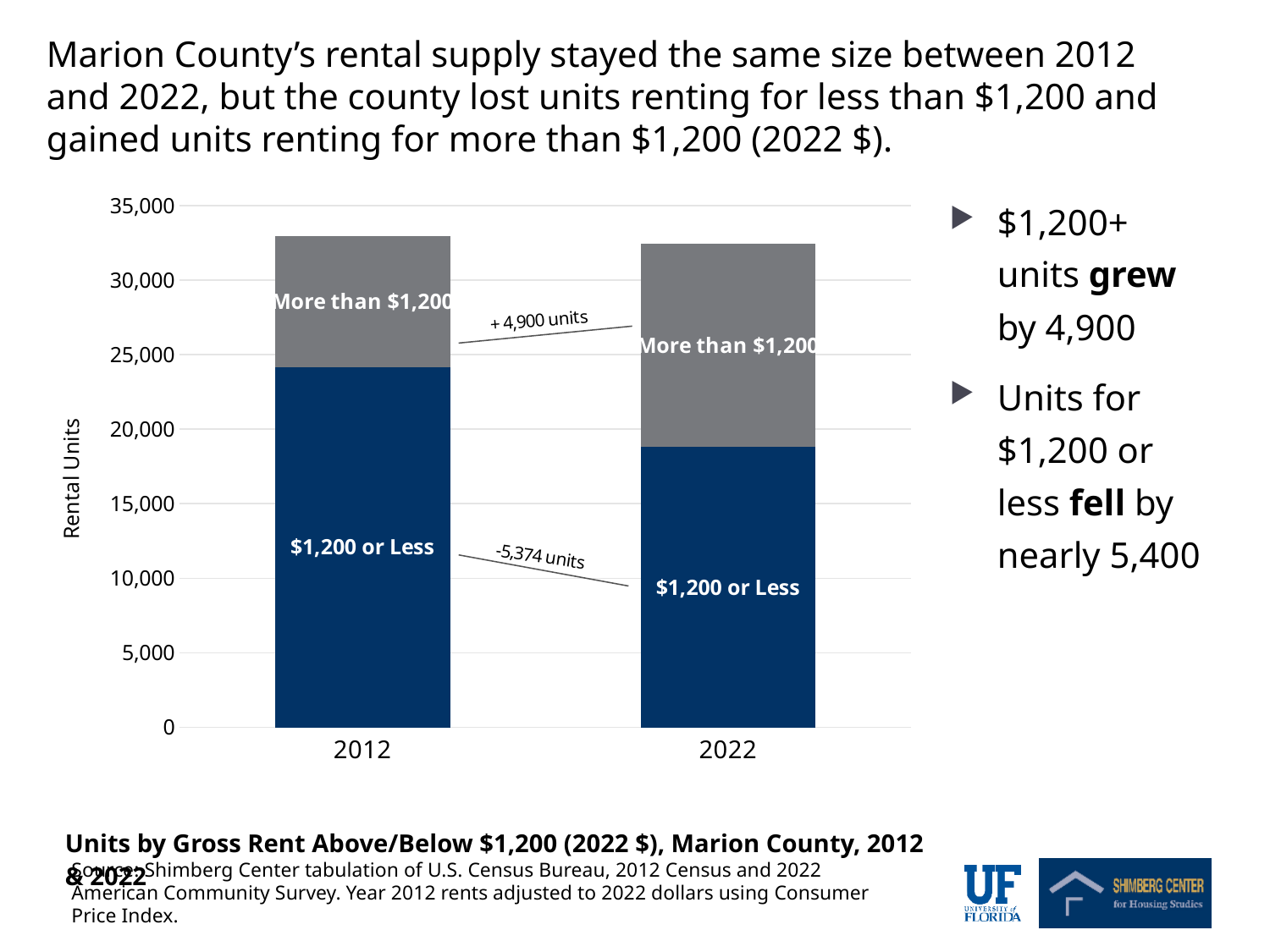
In 2022, which segment is larger: '$1,200 or Less' or 'More than $1,200'? $1,200 or Less How many years (categories) are shown on the x axis of the chart? 2 According to the annotation on the chart, by how many units did the 'More than $1,200' category change between 2012 and 2022? +4,900 units Which year has more '$1,200 or Less' rental units, 2012 or 2022? 2012 Does the number of '$1,200 or Less' units rise or fall from 2012 to 2022? Fall Is the total height of the 2012 bar greater or less than 30,000? greater What is the label on the vertical axis of the chart? Rental Units What kind of chart is shown on the slide? Stacked bar chart Is the value for '$1,200 or Less' units in 2012 greater or less than 20,000? greater According to the annotation on the chart, by how many units did the '$1,200 or Less' category change between 2012 and 2022? -5,374 units Is the value for '$1,200 or Less' units in 2022 greater or less than 20,000? less How many rent categories (series) are stacked in each bar? 2